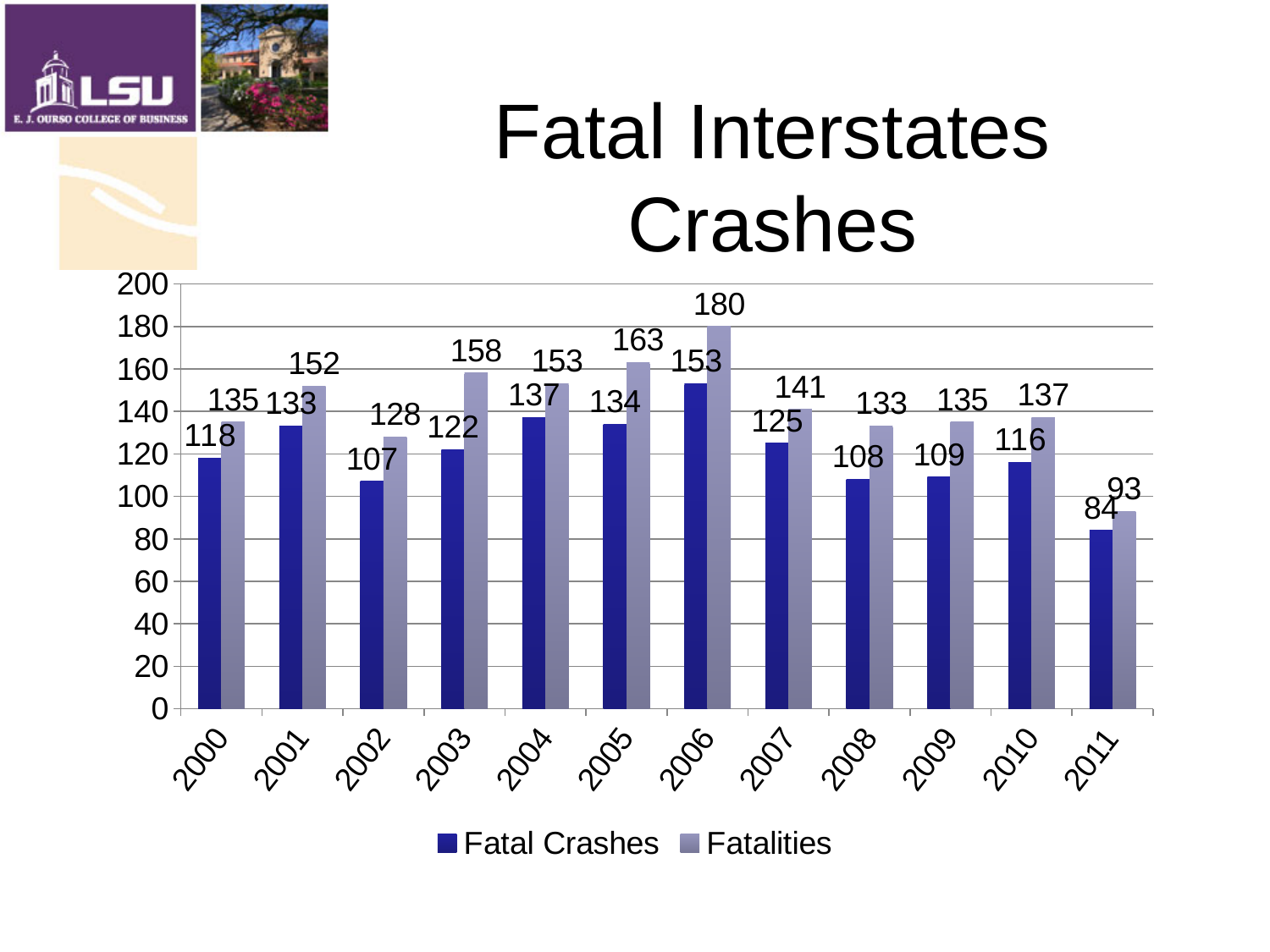
What is the value for Fatal Crashes in 2006? 153 What is the difference between Fatalities in 2006 and Fatalities in 2011? 87 Which year has the lowest Fatal Crashes value? 2011 How many years are shown on the x axis? 12 Which is larger, Fatal Crashes in 2001 or Fatal Crashes in 2002? Fatal Crashes in 2001 What is the title of the chart? Fatal Interstates Crashes Do the Fatal Crashes values rise or fall from 2006 to 2008? Fall What is the value for Fatalities in 2003? 158 What kind of chart is shown on the slide? Bar chart How many series does the legend list? 2 Which year has the highest Fatalities value? 2006 What is the difference between Fatalities and Fatal Crashes in 2006? 27